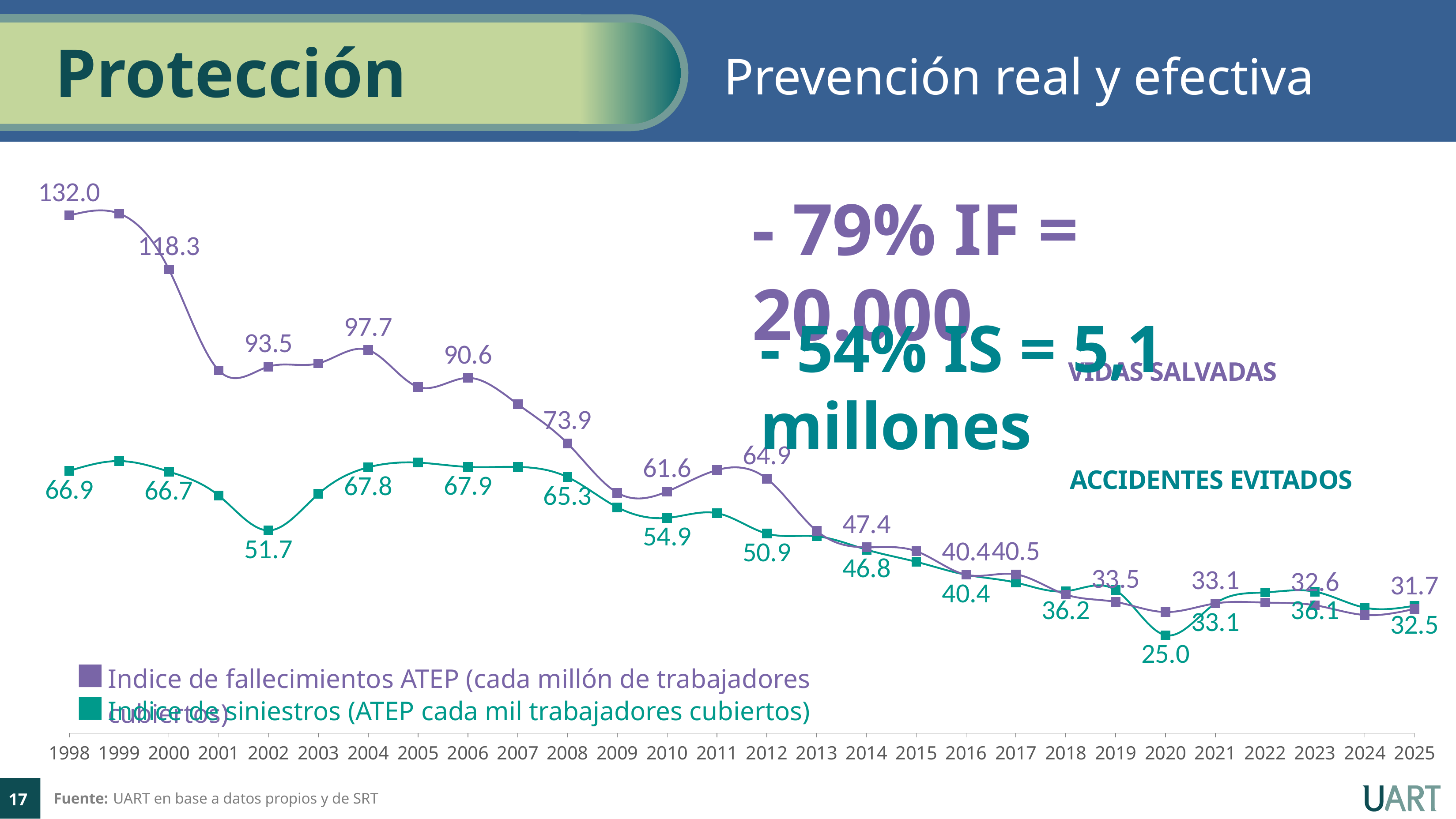
By how much did the Indice de fallecimientos ATEP fall from 1998 to 2025? 100.3 In which year is the Indice de siniestros series at its lowest? 2020 What is the value of the Indice de fallecimientos ATEP series in 1998? 132.0 In 2008, which series has the higher value, Indice de fallecimientos ATEP or Indice de siniestros? Indice de fallecimientos ATEP Does the Indice de fallecimientos ATEP series generally rise or fall from 1998 to 2025? fall What is the difference between the Indice de siniestros values in 1998 and 2025? 34.4 What is the value of the Indice de fallecimientos ATEP series in 2025? 31.7 What is the value of the Indice de siniestros series in 2002? 51.7 What is the value of the Indice de siniestros series in 2020? 25.0 How many series does the legend list? 2 What is the value of the Indice de fallecimientos ATEP series in 2010? 61.6 What kind of chart is shown on the slide? line chart